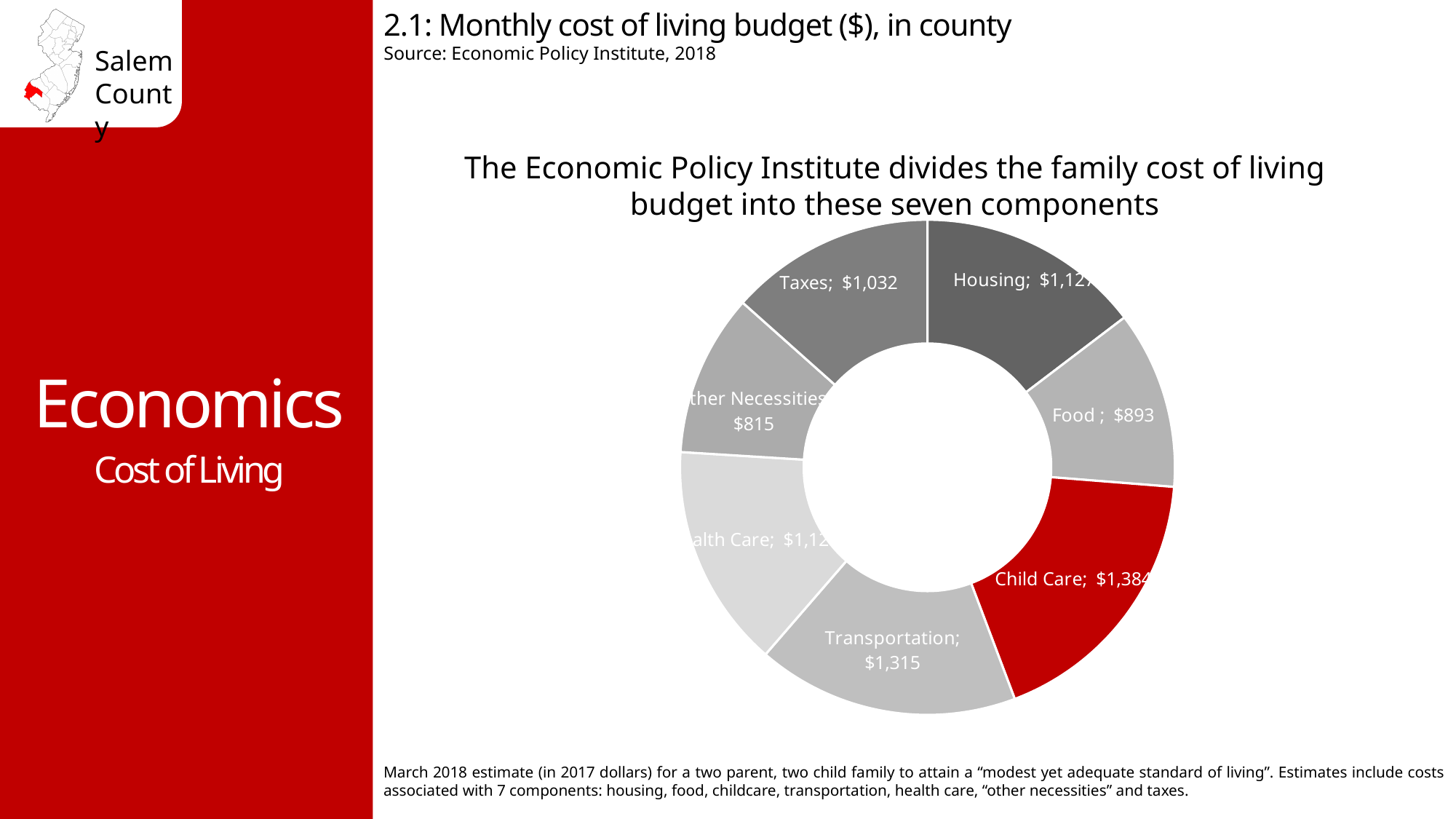
What is the monthly cost for Transportation in the chart? $1,315 Which component is shown in red in the chart? Child Care Which is larger, the monthly cost for Food or for Other Necessities? Food What kind of chart is used on this slide? Doughnut (pie) chart What is the monthly cost for Other Necessities in the chart? $815 Which component has the smallest monthly cost in the chart? Other Necessities What is the difference between the Transportation and Taxes monthly costs? $283 Which component has the largest monthly cost in the chart? Child Care What is the monthly cost for Child Care in the chart? $1,384 What is the monthly cost for Food in the chart? $893 What is the monthly cost for Taxes in the chart? $1,032 How many components are shown in the chart? 7